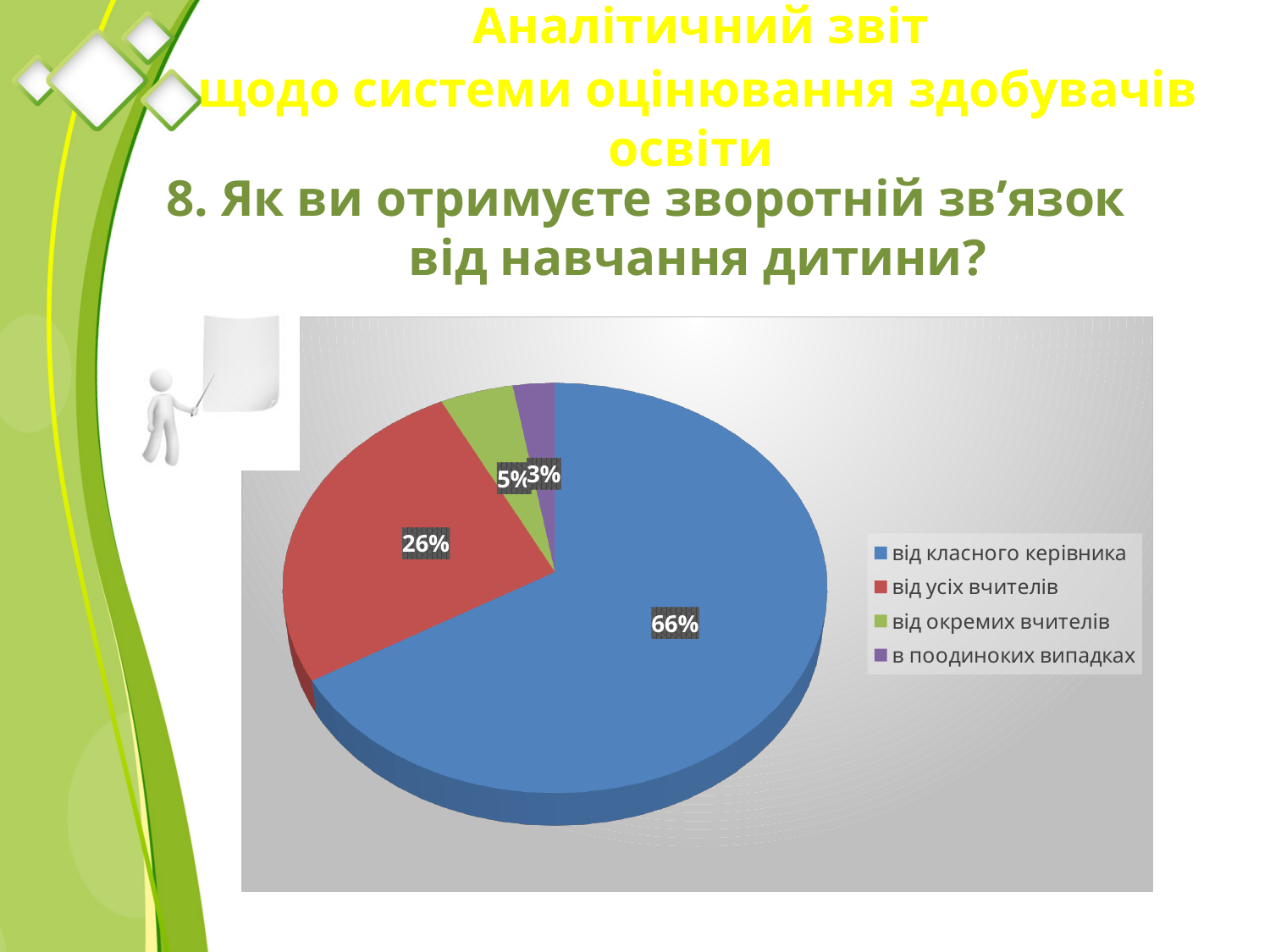
What share of the pie is labelled "від окремих вчителів"? 5% What colour is the slice for "від усіх вчителів"? red Which category has the smallest slice of the pie? в поодиноких випадках What share of the pie is labelled "в поодиноких випадках"? 3% What is the difference in percentage points between "від класного керівника" and "від усіх вчителів"? 40 Which is larger: the slice for "від окремих вчителів" or the slice for "в поодиноких випадках"? від окремих вчителів Which category has the largest slice of the pie? від класного керівника Is the share for "від класного керівника" greater or less than 50%? greater What kind of chart is shown on the slide? pie chart How many categories does the legend list? 4 What share of the pie is labelled "від усіх вчителів"? 26%